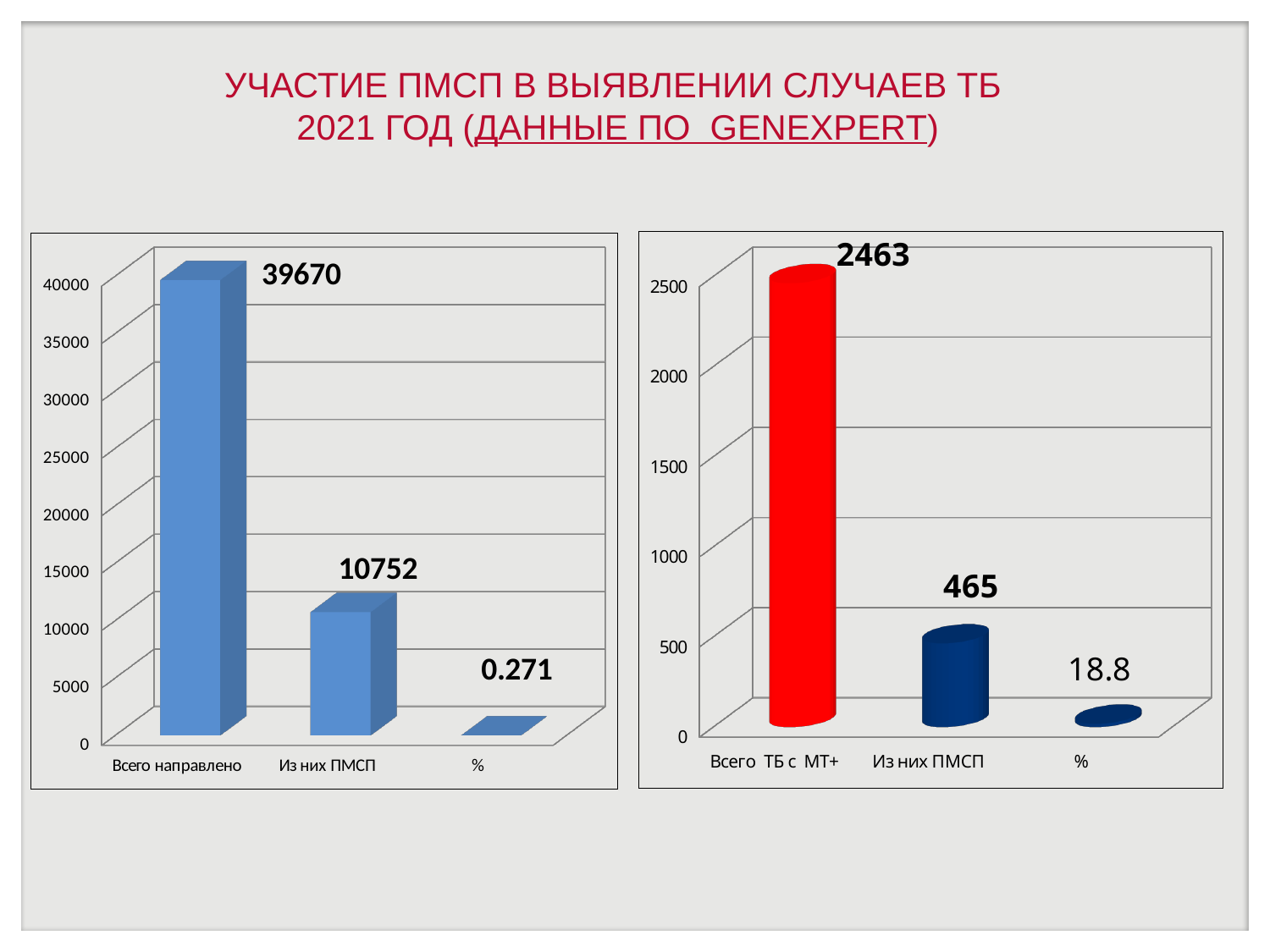
In the right chart, which category has the lowest value? % In the left chart, what is the value for Из них ПМСП? 10752 In the left chart, what is the difference between Всего направлено and Из них ПМСП? 28918 In the right chart, what is the value for Из них ПМСП? 465 In the left chart, what is the value for Всего направлено? 39670 What type of chart is the left chart? bar chart In the left chart, what is the value for %? 0.271 In the right chart, what is the value for Всего ТБ с МТ+? 2463 How many categories are shown in the right chart? 3 In the left chart, which category has the highest value? Всего направлено In the right chart, what is the value for %? 18.8 In the right chart, what is the difference between Всего ТБ с МТ+ and Из них ПМСП? 1998